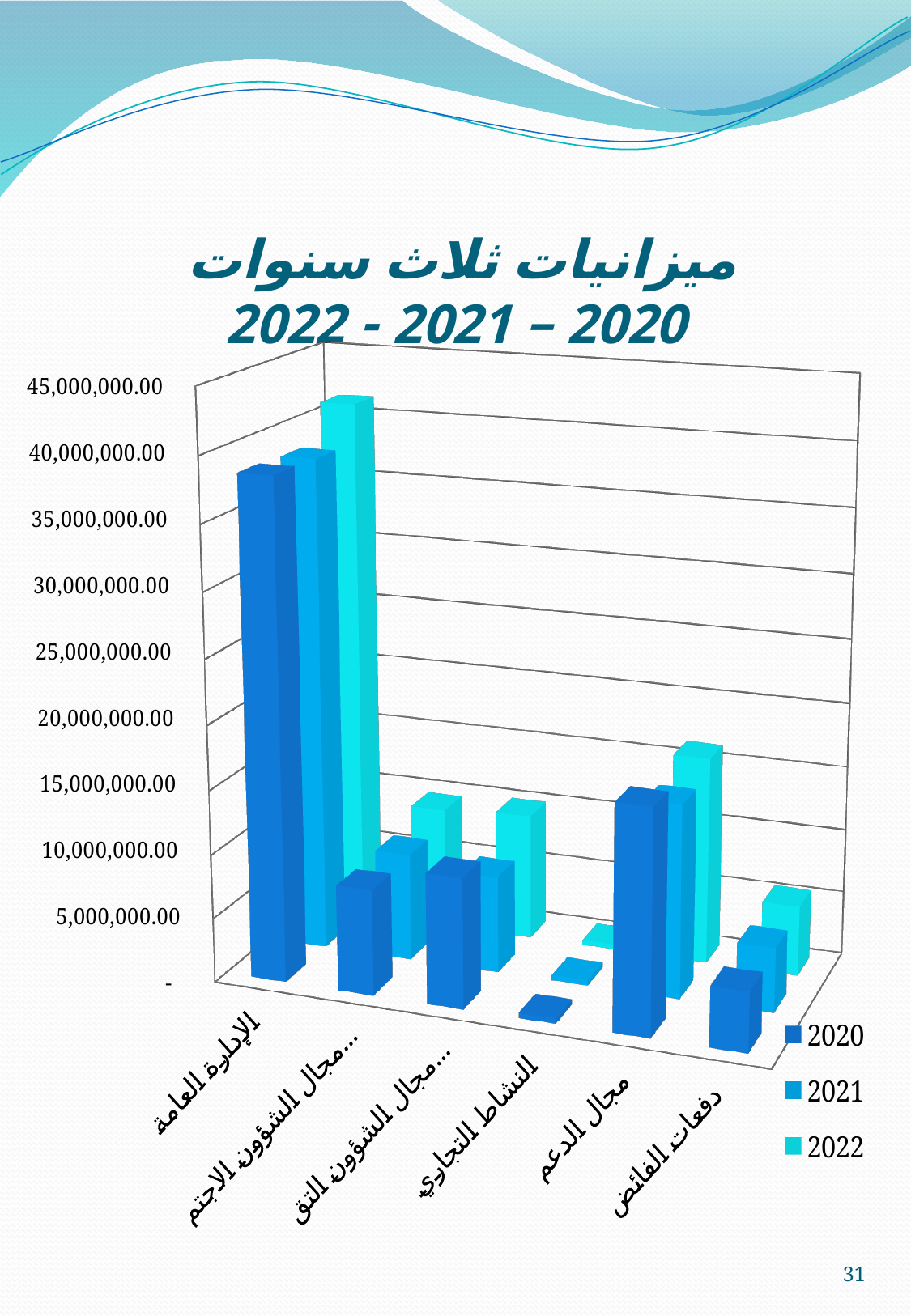
What kind of chart is shown on the slide? bar chart Is the value for مجال الدعم in 2020 greater or less than 10,000,000.00? greater How many categories are shown on the x axis? 6 How many series does the legend list? 3 Is the value for الإدارة العامة in 2022 greater or less than 30,000,000.00? greater Which series is shown in the lightest (cyan) colour in the legend? 2022 Do the values for الإدارة العامة rise or fall from 2020 to 2022? rise Which category has the highest value for 2022? الإدارة العامة Which is larger for 2020: الإدارة العامة or مجال الدعم? الإدارة العامة Is the value for دفعات الفائض in 2020 greater or less than 10,000,000.00? less Which category has the lowest value for 2020? النشاط التجاري